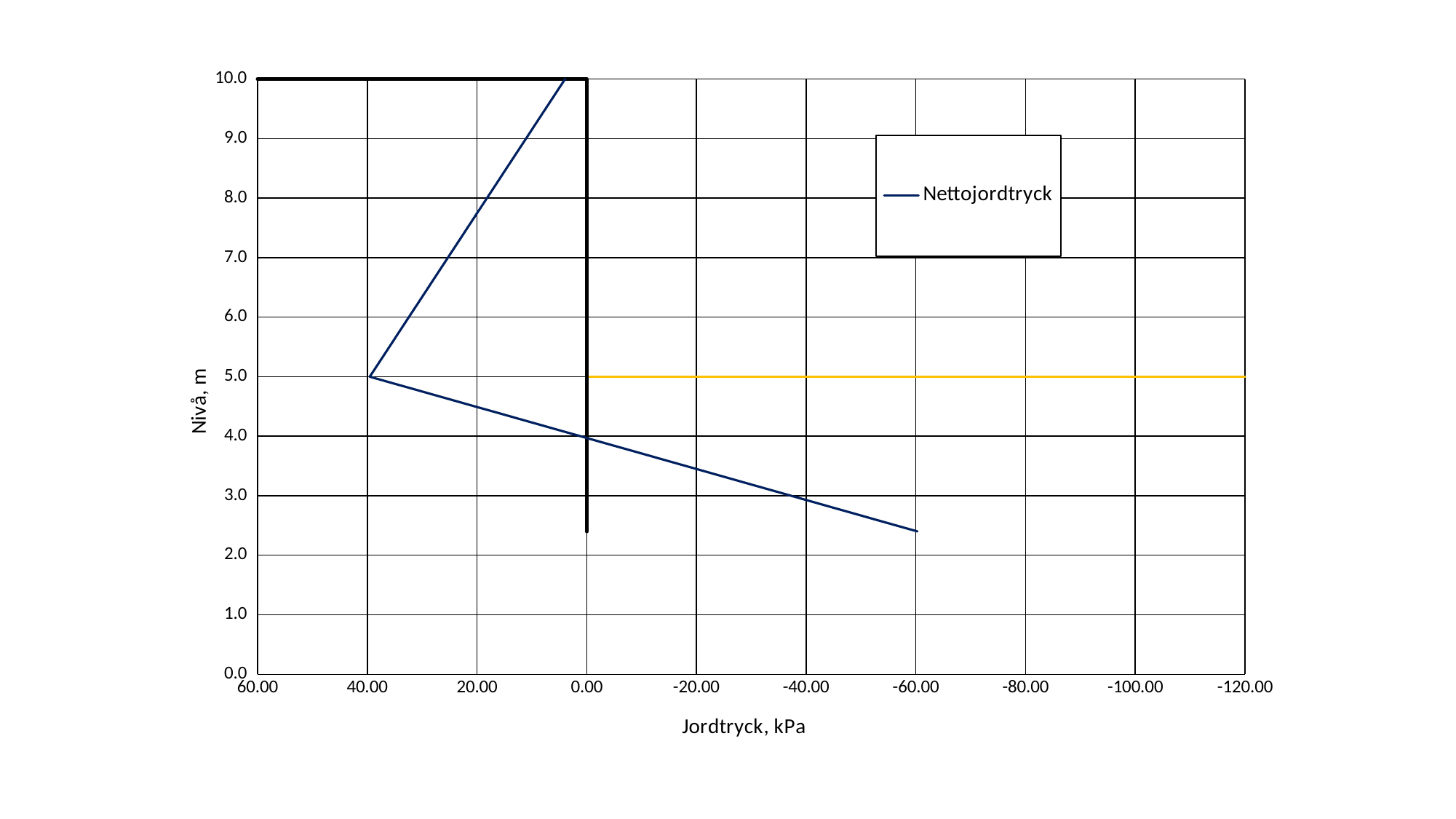
What is the name of the series shown in the legend? Nettojordtryck How many tick labels are shown on the x axis (Jordtryck, kPa)? 10 Is the Nettojordtryck value at level 5.0 m larger than the value at level 10.0 m? yes Is the Nettojordtryck value at level 9.0 m greater or less than 20.00? less What kind of chart is shown on the slide? line chart Going down from level 10.0 m to level 5.0 m, does the Nettojordtryck value increase or decrease? increase How many series does the legend list? 1 Is the Nettojordtryck value at level 7.0 m greater or less than 20.00? greater At which level (Nivå, m) is the horizontal yellow line drawn? 5.0 Is the Nettojordtryck value at level 3.0 m greater or less than -20.00? less At which level (Nivå, m) does the Nettojordtryck line reach its highest value? 5.0